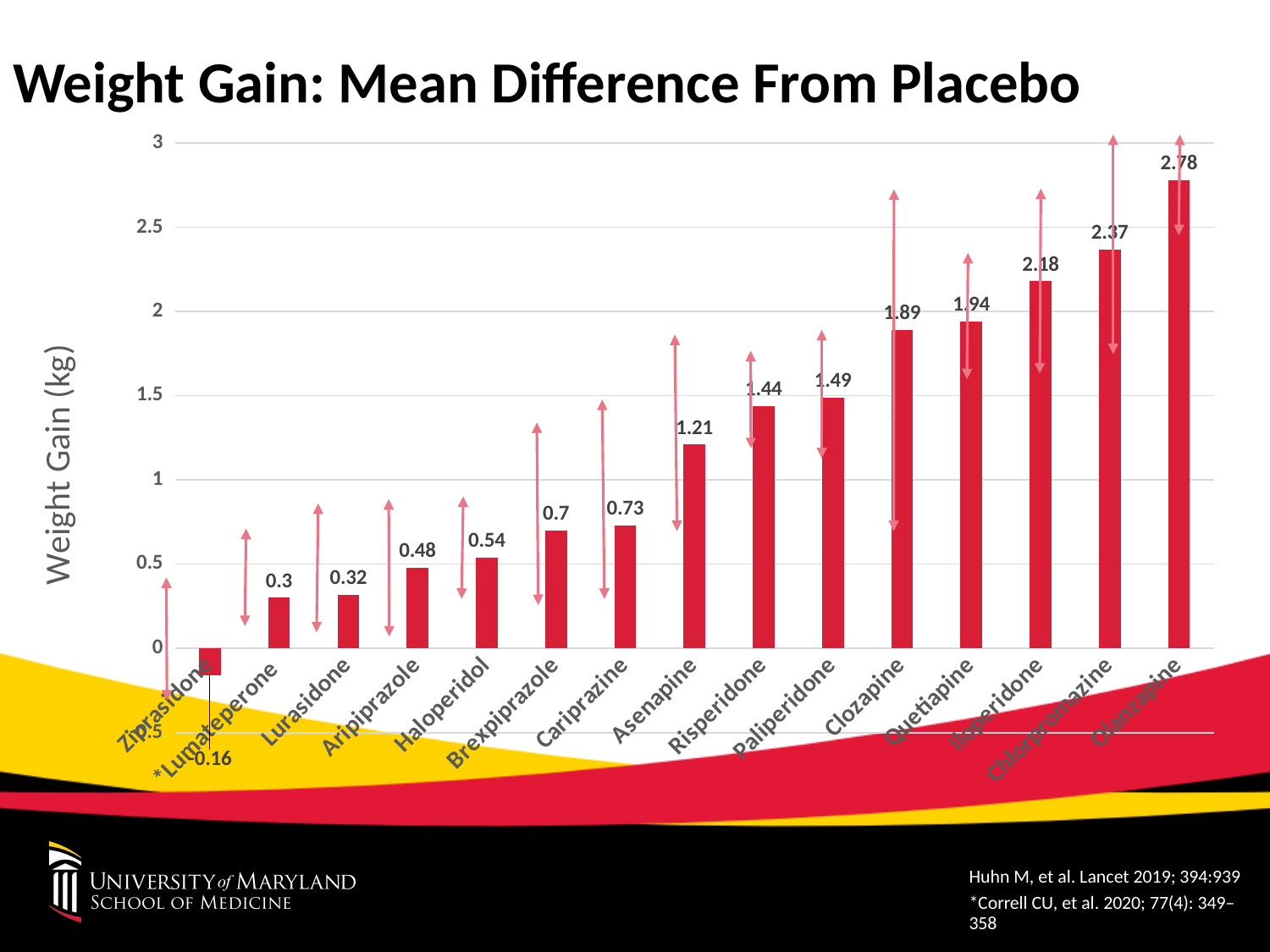
What is the difference between the values for Olanzapine and Chlorpromazine? 0.41 What type of chart is shown? Bar chart Which drug has the lowest mean weight gain difference from placebo? Ziprasidone Do the bar values generally rise or fall from left to right along the x axis? Rise What is the mean weight gain difference from placebo for Olanzapine? 2.78 What is the value shown for Haloperidol? 0.54 How many drugs are shown on the x axis? 15 What is the value shown for Clozapine? 1.89 Which drug has the highest mean weight gain difference from placebo? Olanzapine What is the label of the y axis? Weight Gain (kg) What is the value shown for Ziprasidone? -0.16 Which has a larger value, Risperidone or Asenapine? Risperidone